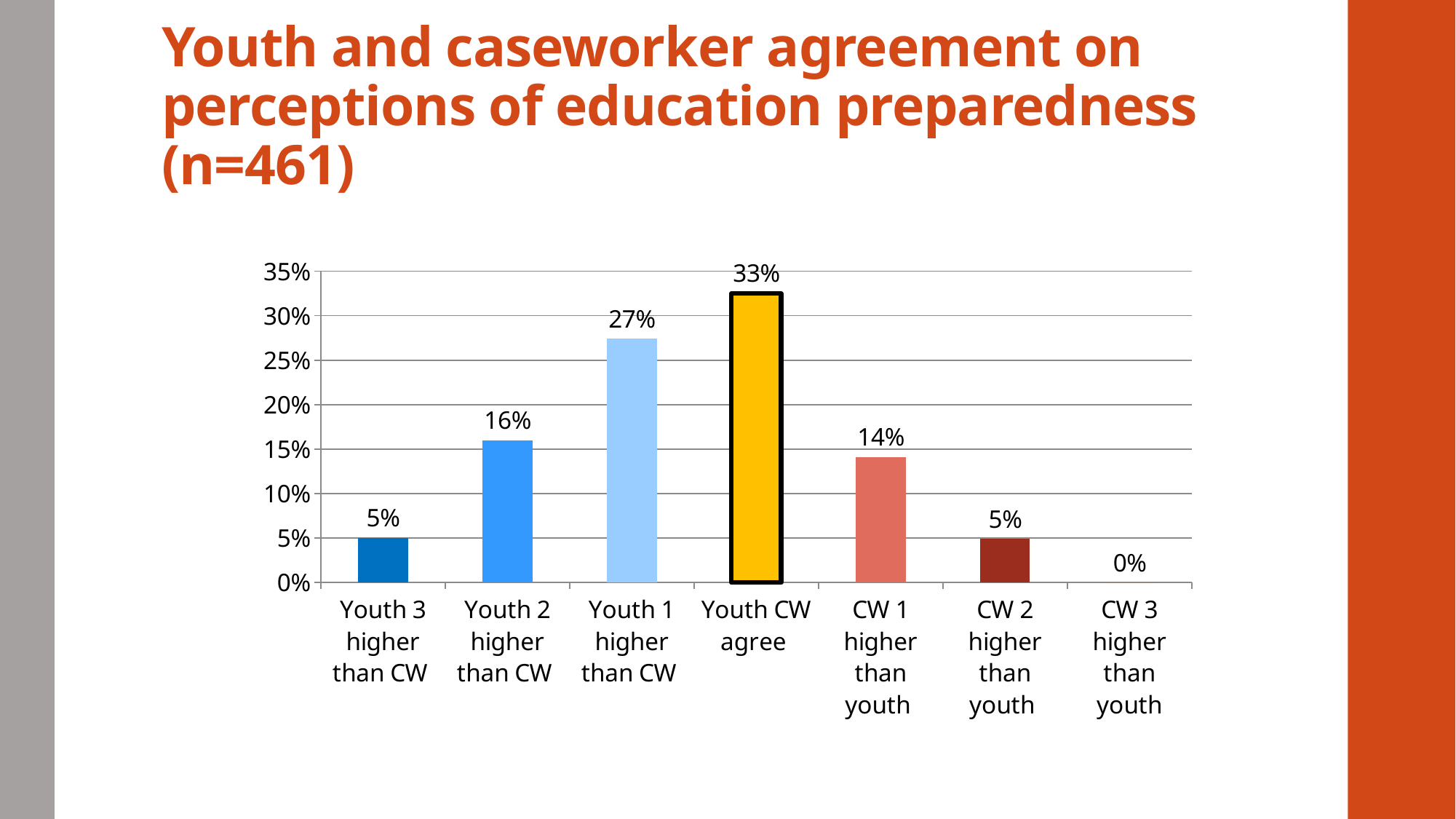
What is the difference between "Youth 2 higher than CW" and "CW 1 higher than youth"? 2% What is the difference between "Youth CW agree" and "Youth 1 higher than CW"? 6% What is the value for "CW 3 higher than youth"? 0% What is the value for "Youth CW agree"? 33% Which is larger, "Youth 2 higher than CW" or "CW 2 higher than youth"? Youth 2 higher than CW Which category has the lowest value? CW 3 higher than youth What kind of chart is shown on the slide? Bar chart What colour is the bar for "Youth CW agree"? Yellow How many categories are shown on the x axis? 7 Which category has the highest value? Youth CW agree What is the value for "CW 1 higher than youth"? 14% What is the value for "Youth 1 higher than CW"? 27%